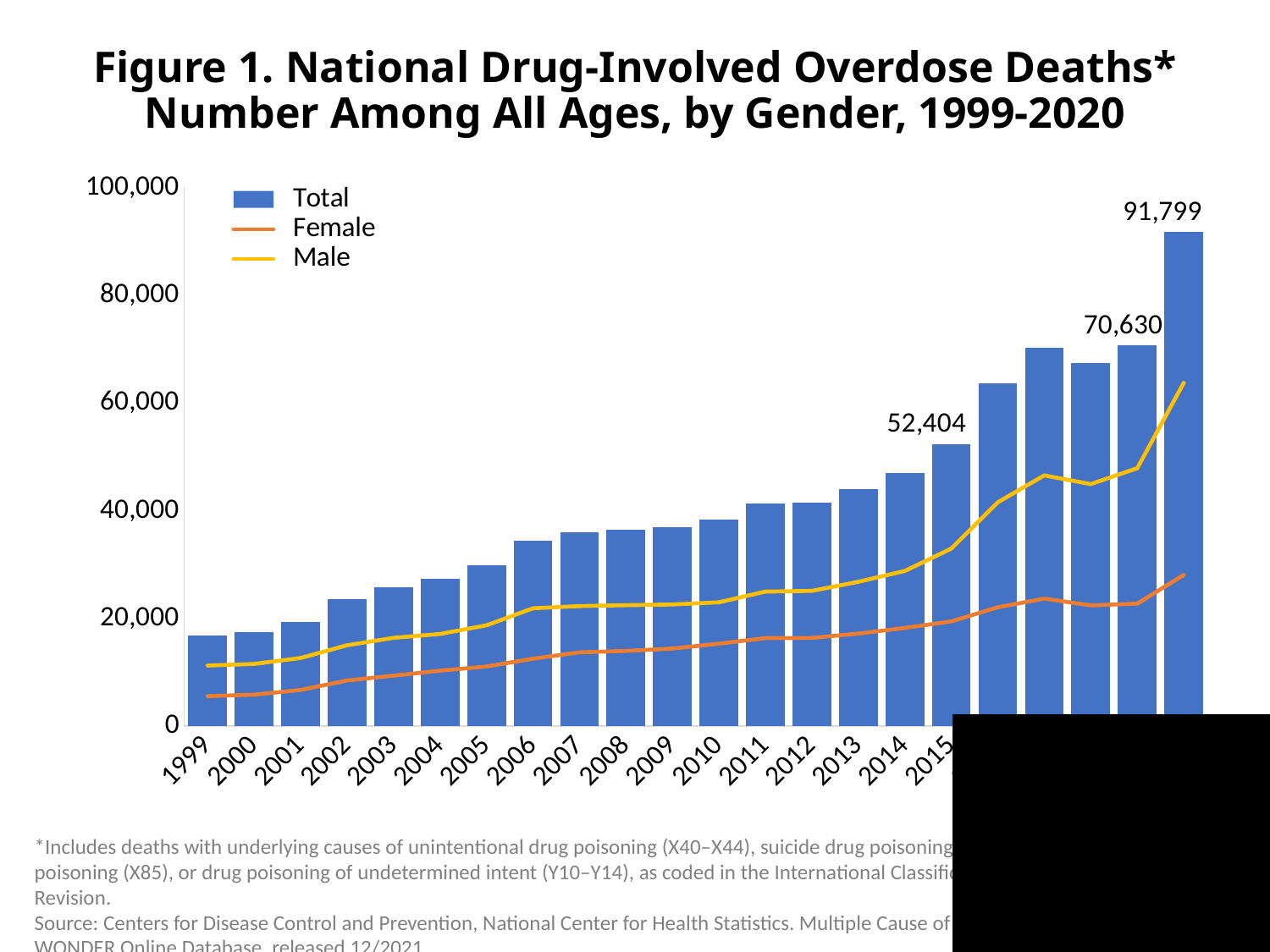
How many series does the legend list? 3 What kind of chart is shown on the slide? A bar chart with line series What is the difference between the labeled Total values 70,630 and 52,404? 18,226 What is the value shown on the tallest Total bar? 91,799 Which series are listed in the legend? Total, Female, Male In 2015, which is larger, the Male value or the Female value? Male Is the Total value for 1999 greater or less than 20,000? less Which year has the lowest Total bar? 1999 How many bars (years) are plotted in the chart? 22 What is the difference between the two highest labeled Total values, 91,799 and 70,630? 21,169 What is the data label shown on the Total bar for 2015? 52,404